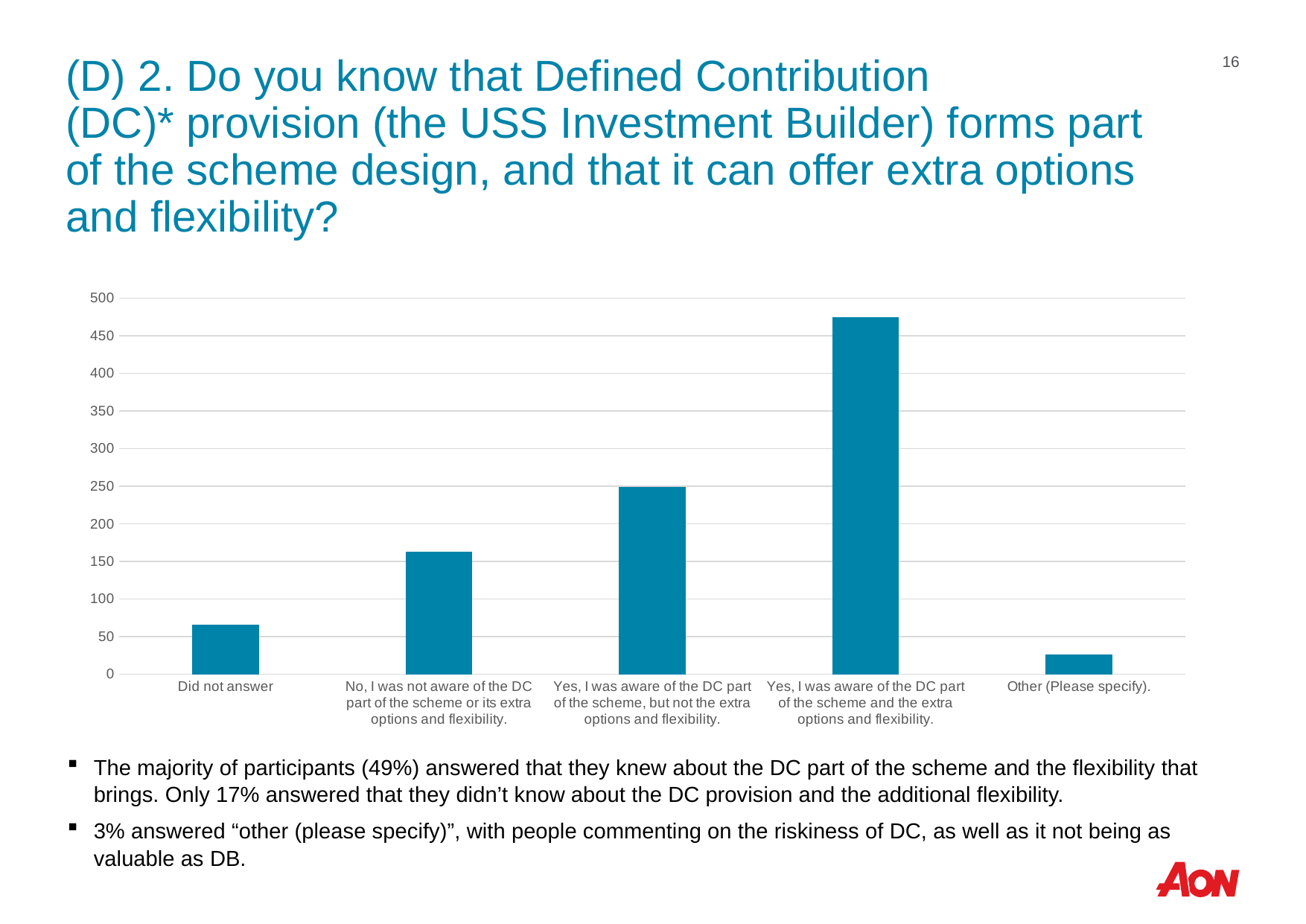
Which is larger: the value for "Did not answer" or the value for "Other (Please specify)."? Did not answer Is the value for "Yes, I was aware of the DC part of the scheme, but not the extra options and flexibility." greater or less than 200? greater Is the value for "Other (Please specify)." greater or less than 50? less How many categories are shown on the x axis of the chart? 5 Which category has the lowest bar in the chart? Other (Please specify). Is the value for "Yes, I was aware of the DC part of the scheme and the extra options and flexibility." greater or less than 450? greater Which category has the highest bar in the chart? Yes, I was aware of the DC part of the scheme and the extra options and flexibility. Which is larger: the value for "No, I was not aware of the DC part of the scheme or its extra options and flexibility." or the value for "Yes, I was aware of the DC part of the scheme, but not the extra options and flexibility."? Yes, I was aware of the DC part of the scheme, but not the extra options and flexibility. What is the highest value shown on the y axis of the chart? 500 What kind of chart is shown on the slide? bar chart